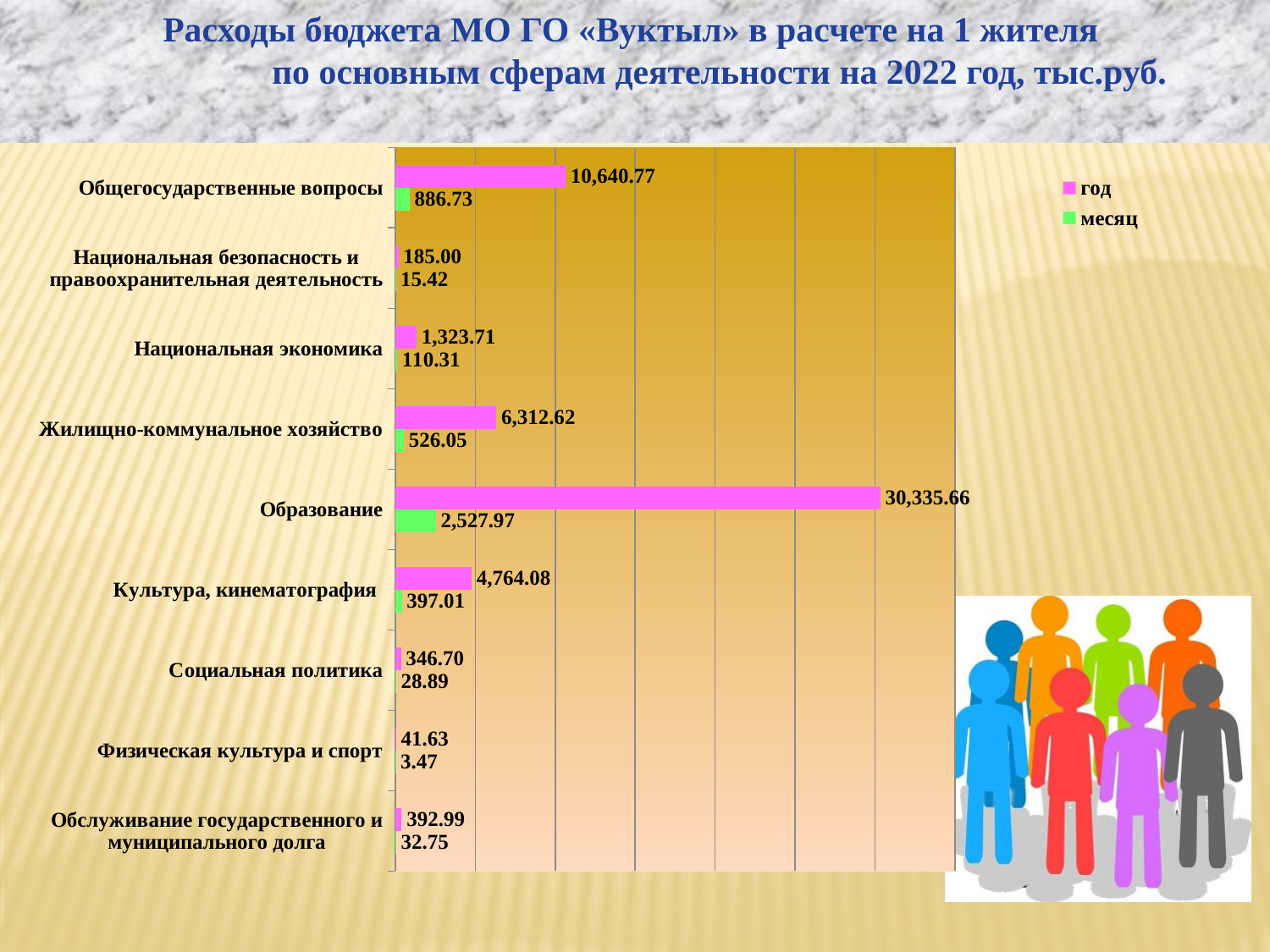
What is the value of the "год" series for Культура, кинематография? 4,764.08 What kind of chart is shown on the slide? Bar chart Which has the larger "год" value: Жилищно-коммунальное хозяйство or Культура, кинематография? Жилищно-коммунальное хозяйство Which category has the lowest "месяц" value? Физическая культура и спорт How many categories are shown on the chart? 9 What is the value of the "месяц" series for Жилищно-коммунальное хозяйство? 526.05 What is the difference between the "год" values for Общегосударственные вопросы and Жилищно-коммунальное хозяйство? 4,328.15 Which category has the highest "год" value? Образование How many series does the legend list? 2 What is the value of the "год" series for Образование? 30,335.66 What is the value of the "месяц" series for Социальная политика? 28.89 Which colour represents the "месяц" series in the legend? Green